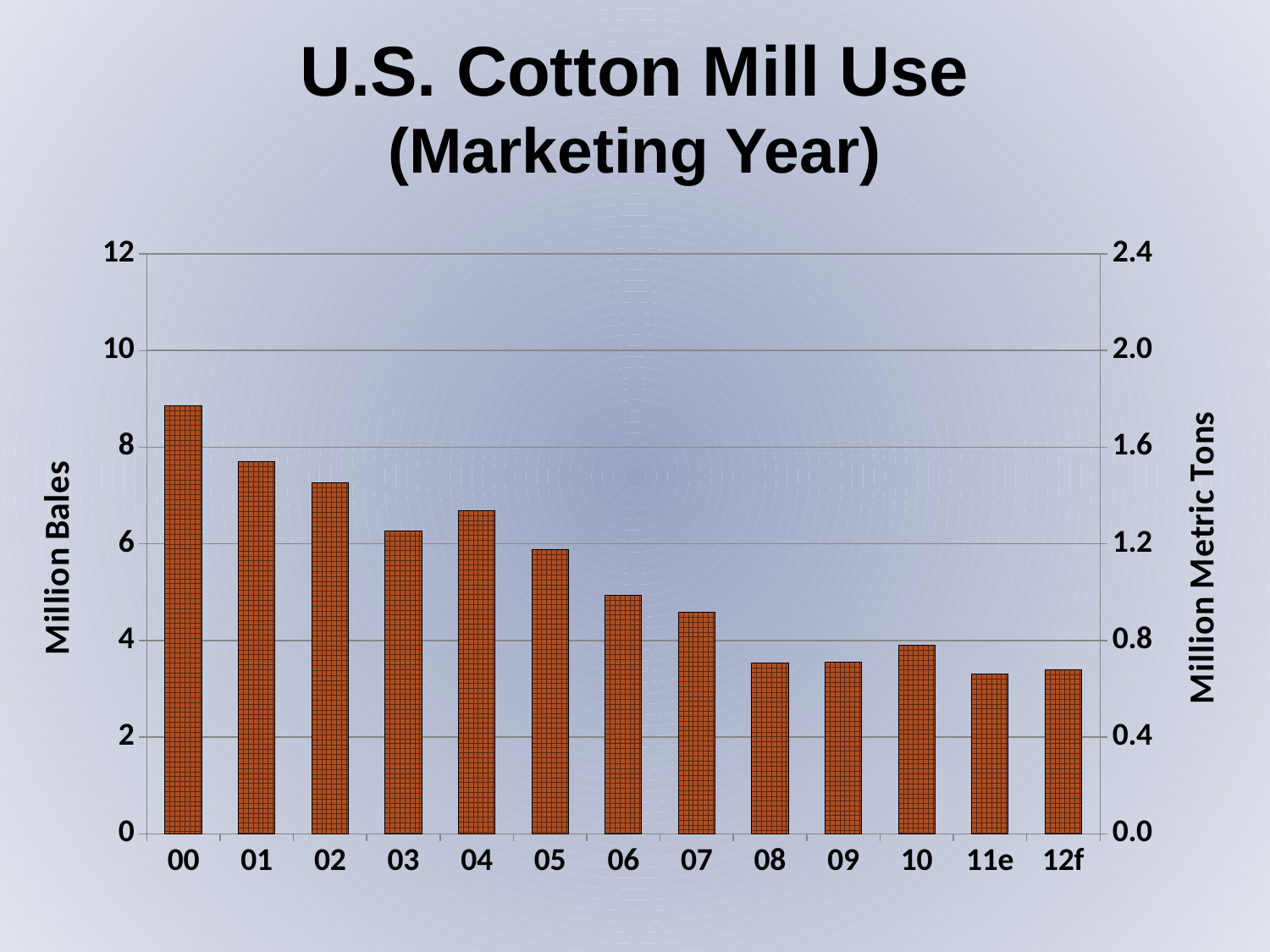
What kind of chart is shown on the slide? Bar chart What is the label on the right-hand vertical axis? Million Metric Tons Which is larger, the value for 01 or the value for 02? 01 Is the value for 07 greater or less than 4 million bales? greater Is the value for 00 greater or less than 8 million bales? greater Is the value for 04 greater or less than 6 million bales? greater How many marketing years are plotted on the chart? 13 Which marketing year has the highest cotton mill use? 00 Do the values generally rise or fall from 00 to 12f? Fall Which is larger, the value for 03 or the value for 04? 04